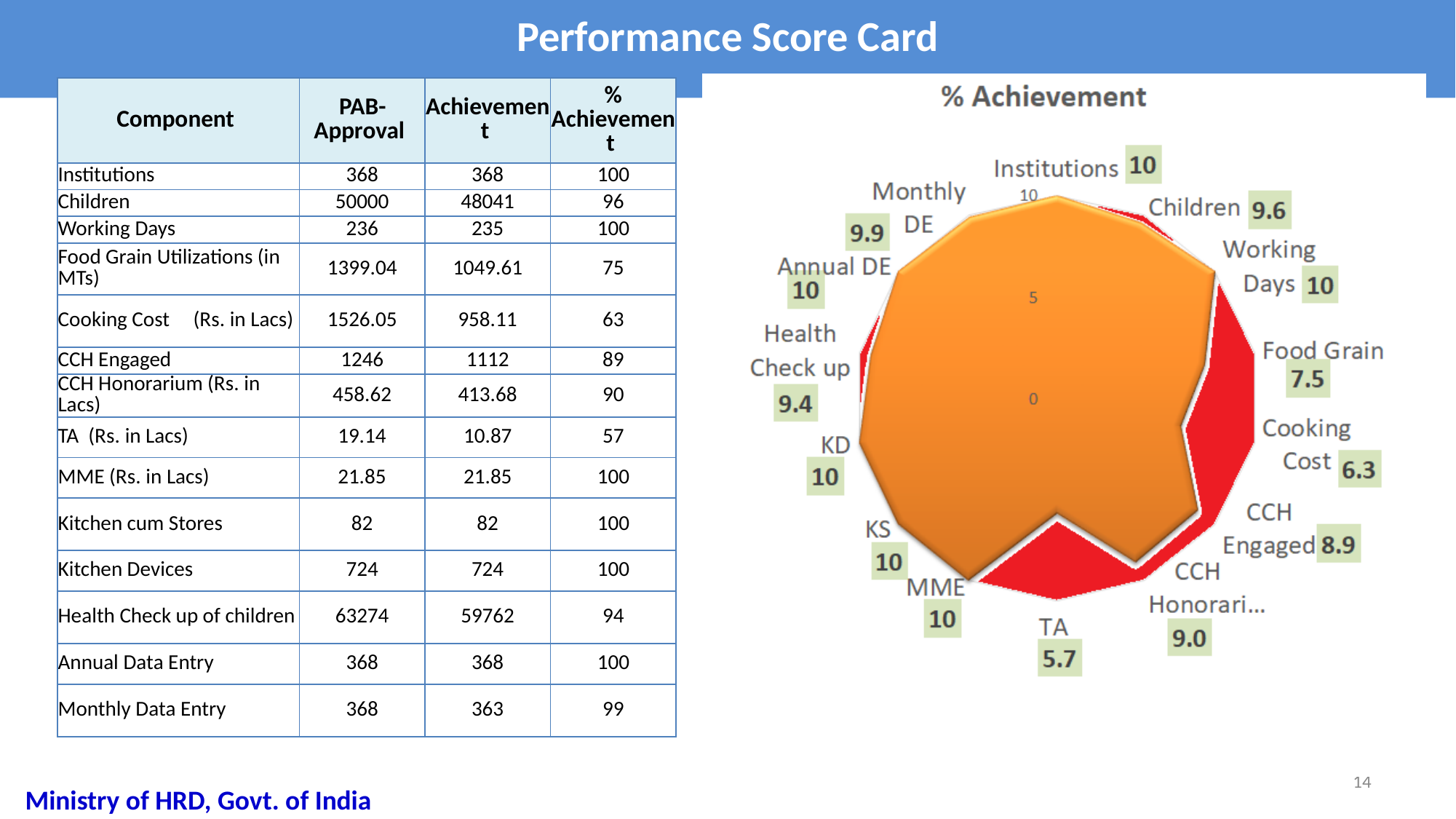
What is the value for Monthly DE in the chart? 9.9 What is the value for Cooking Cost in the chart? 6.3 What is the difference between the values for CCH Engaged and Cooking Cost in the chart? 2.6 How many categories are plotted in the chart? 14 What is the value for Food Grain in the chart? 7.5 Which category has the lowest value in the chart? TA What is the value for Children in the chart? 9.6 What is the value for TA in the chart? 5.7 Which is larger in the chart, the value for Health Check up or the value for Children? Children What kind of chart is shown on the slide? radar chart Is the value for TA in the chart greater or less than 5? greater What is the title of the chart? % Achievement